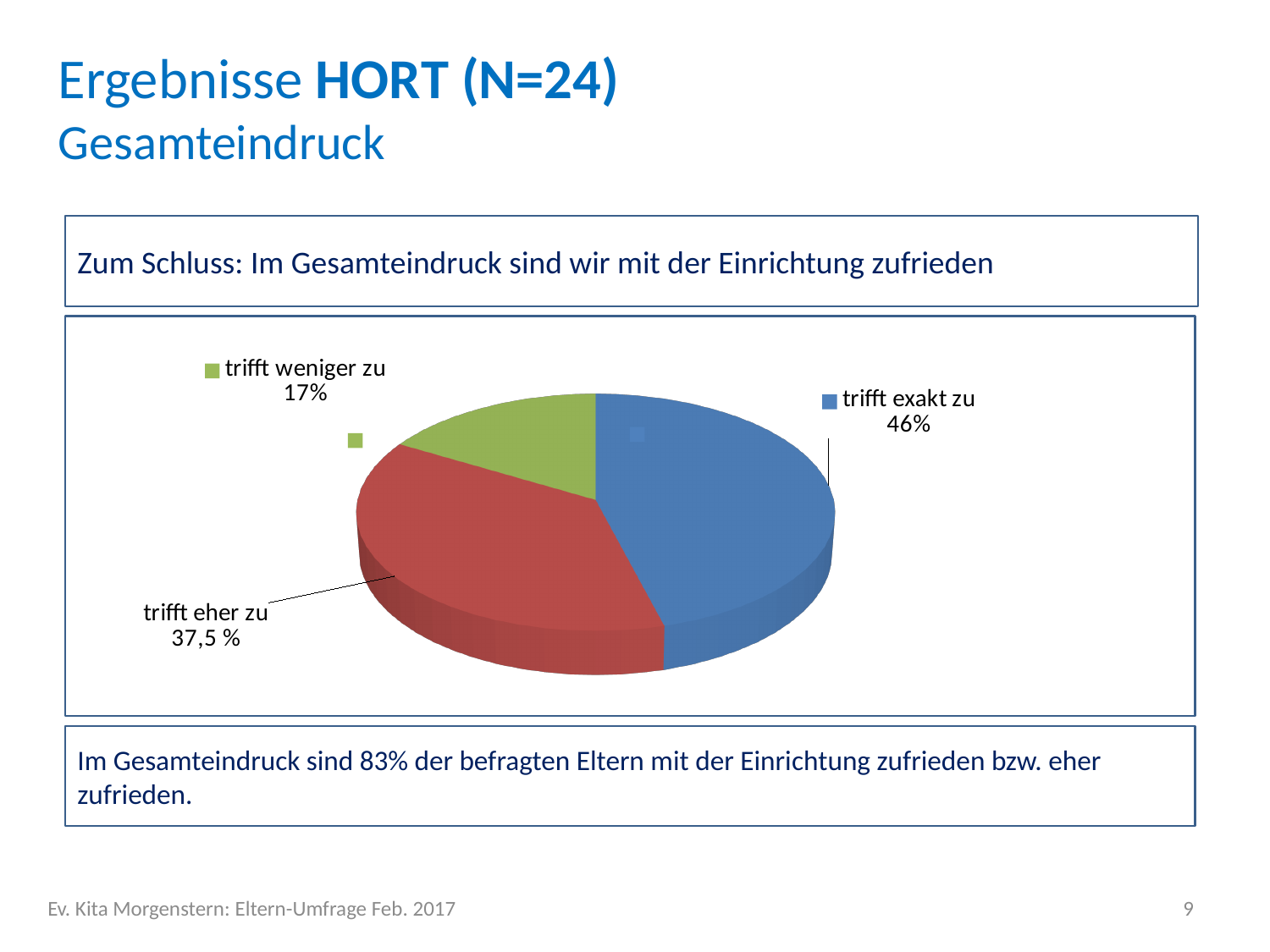
Which category has the smallest slice of the pie? trifft weniger zu What share of the pie does "trifft exakt zu" represent? 46% What kind of chart is shown on the slide? pie chart By how many percentage points does "trifft exakt zu" exceed "trifft weniger zu"? 29 percentage points Which category has the largest slice of the pie? trifft exakt zu What colour is the slice for "trifft exakt zu"? blue What percentage is shown for "trifft weniger zu"? 17% Which is larger, the slice for "trifft eher zu" or the slice for "trifft weniger zu"? trifft eher zu How many slices does the pie chart have? 3 What percentage is shown for "trifft eher zu"? 37,5 % What colour is the slice for "trifft weniger zu"? green What percentage is shown for "trifft exakt zu"? 46%